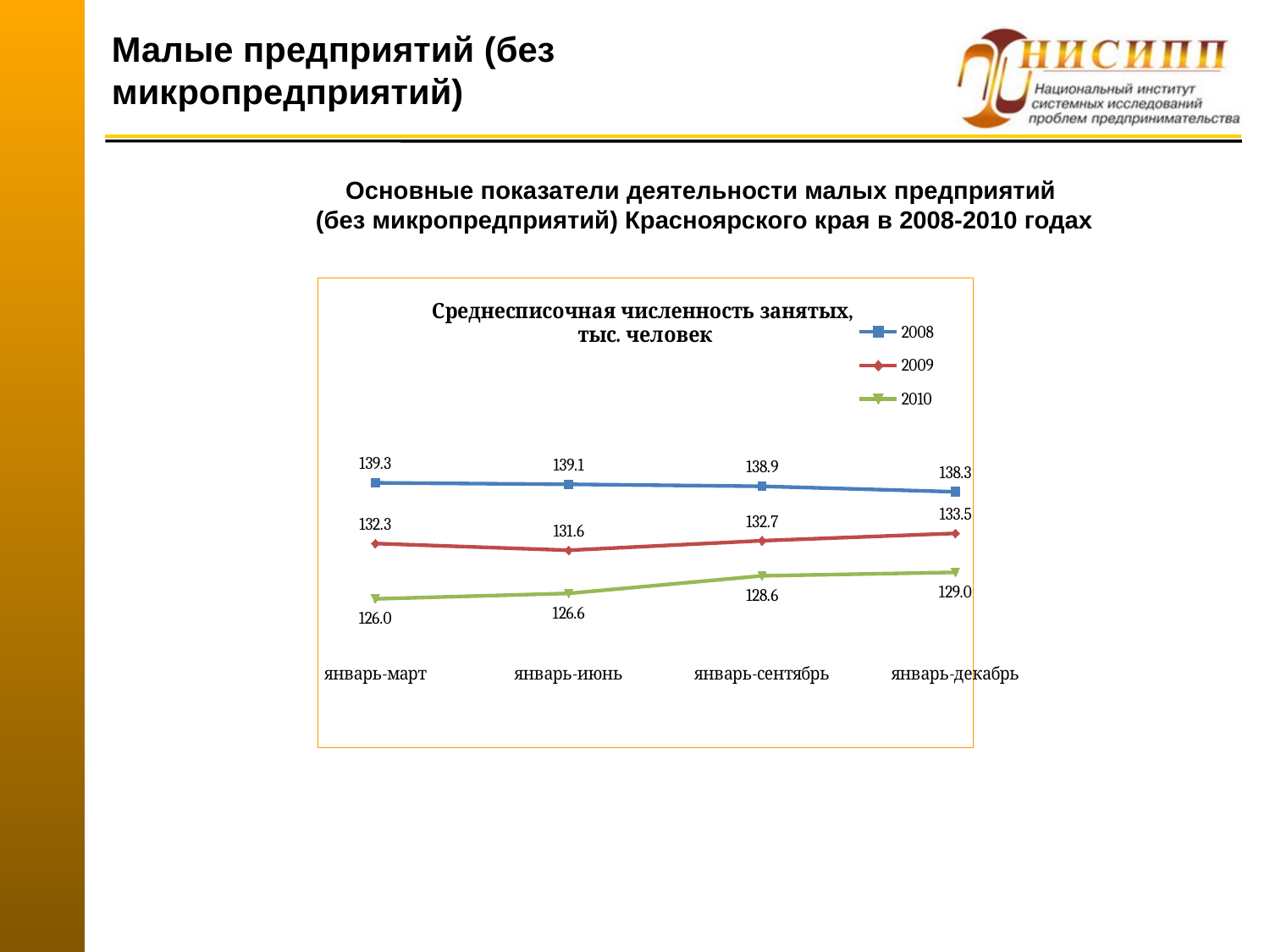
How many periods are plotted along the x axis? 4 What is the title of the chart? Среднесписочная численность занятых, тыс. человек What type of chart is shown on the slide? line chart In which period is the 2008 series highest? январь-март How many series does the legend list? 3 In which period is the 2010 series lowest? январь-март Which is larger in январь-декабрь: the 2009 value or the 2010 value? 2009 What is the value for 2008 in январь-март? 139.3 Does the 2008 series rise or fall across the periods from январь-март to январь-декабрь? fall What is the difference between the 2008 and 2010 values in январь-сентябрь? 10.3 What is the value for 2010 in январь-декабрь? 129.0 What is the value for 2009 in январь-июнь? 131.6